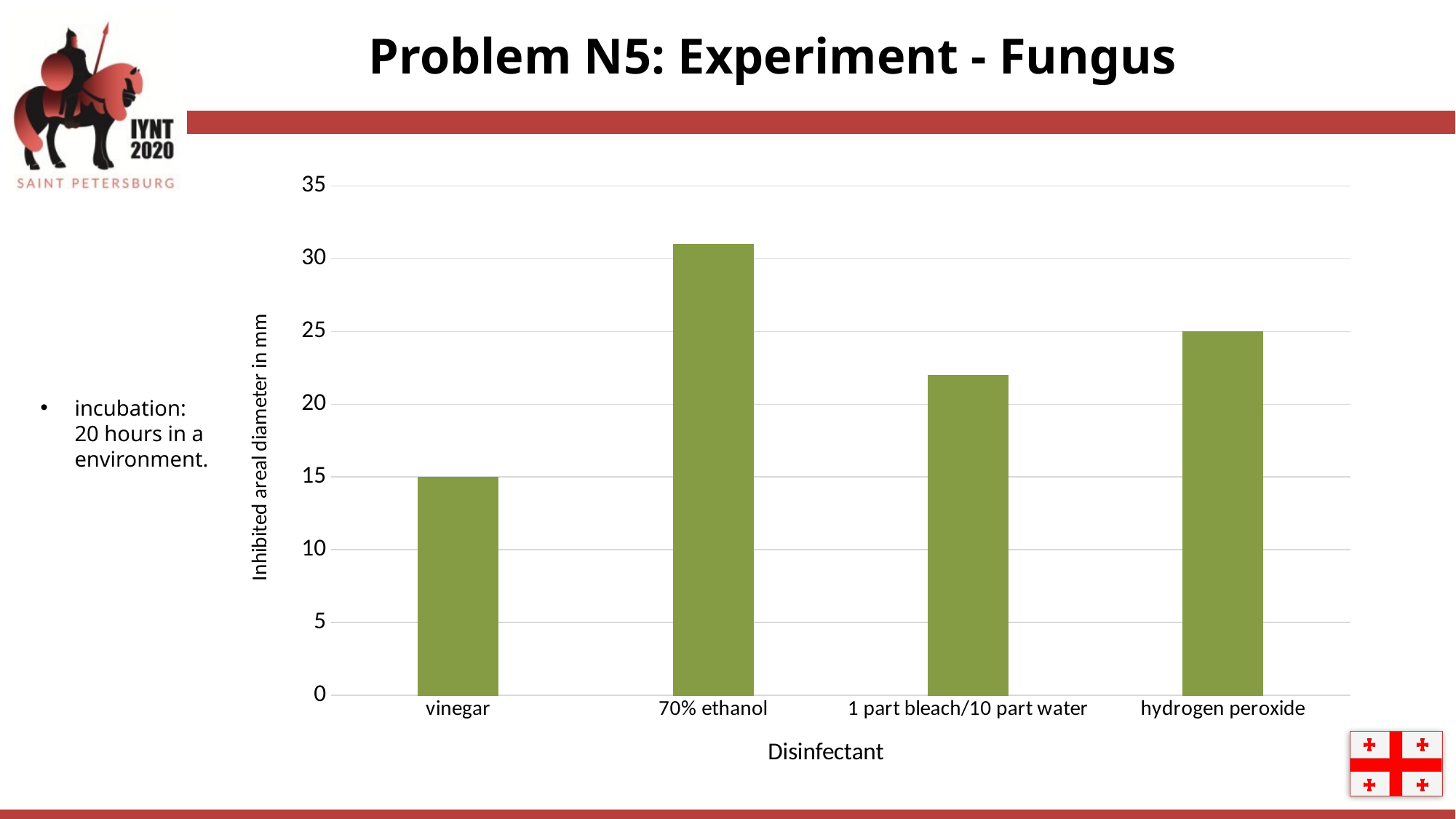
What is the difference in inhibited areal diameter between hydrogen peroxide and vinegar, in mm? 10 What type of chart is shown on the slide? bar chart What is the label of the horizontal axis? Disinfectant What is the inhibited areal diameter in mm for hydrogen peroxide? 25 How many disinfectants are plotted on the chart? 4 What is the inhibited areal diameter in mm for vinegar? 15 What is the label of the vertical axis? Inhibited areal diameter in mm Is the value for 70% ethanol greater or less than 30? greater Which disinfectant has the lowest inhibited areal diameter? vinegar Which disinfectant has the highest inhibited areal diameter? 70% ethanol Which has a larger inhibited areal diameter, 70% ethanol or hydrogen peroxide? 70% ethanol Is the value for 1 part bleach/10 part water greater or less than 25? less